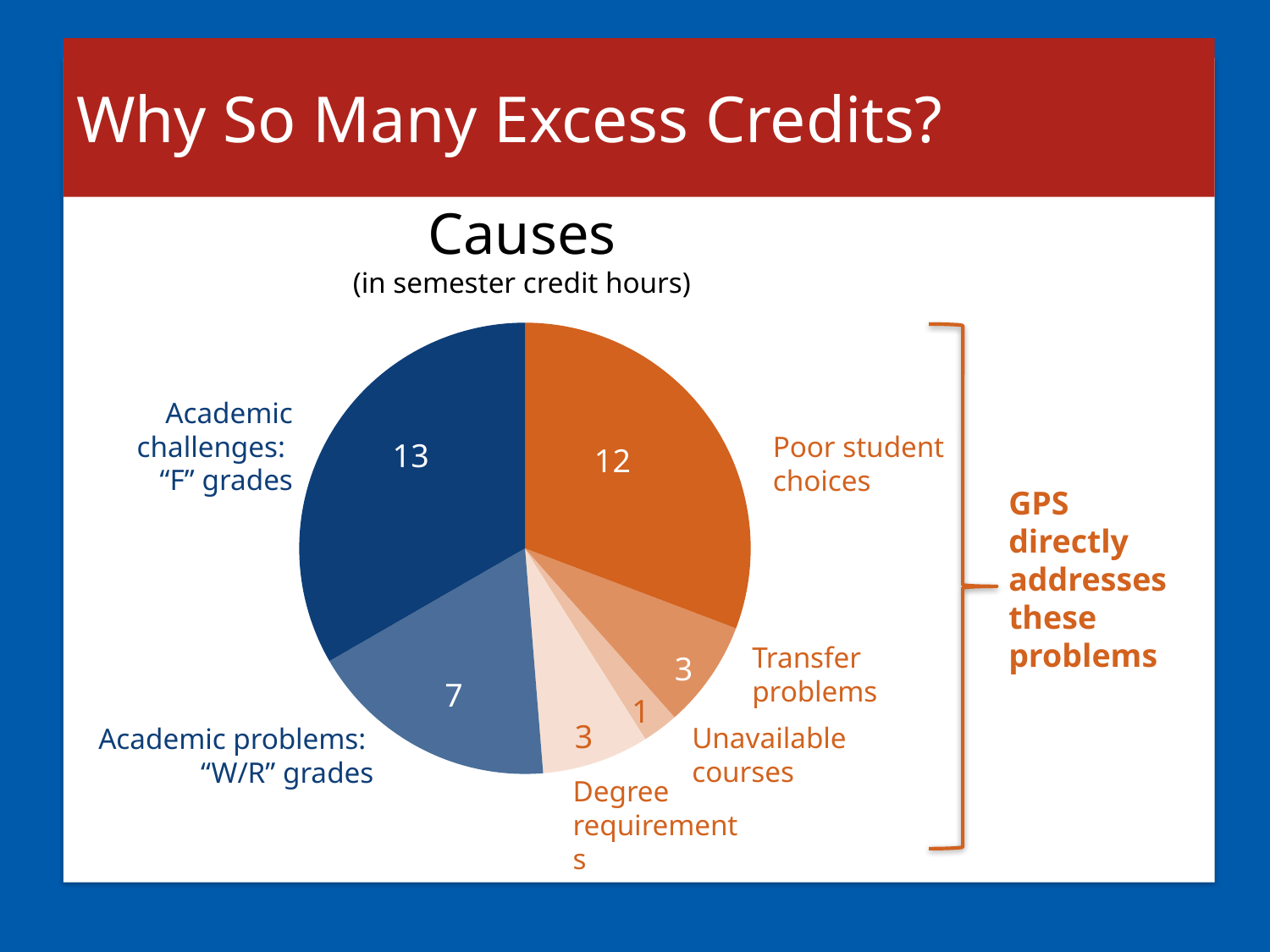
In what unit are the values in the pie chart expressed, according to the chart subtitle? semester credit hours Which is larger, the value for Poor student choices or the value for Academic problems: "W/R" grades? Poor student choices What is the value for Academic problems: "W/R" grades? 7 Which cause accounts for the smallest slice of the pie? Unavailable courses What is the difference between the values for Academic challenges: "F" grades and Poor student choices? 1 What kind of chart is shown on the slide? pie chart What is the value for Transfer problems? 3 How many semester credit hours are attributed to Academic challenges: "F" grades? 13 What is the value for Poor student choices? 12 What is the value for Unavailable courses? 1 Which cause accounts for the largest slice of the pie? Academic challenges: "F" grades How many slices does the pie chart have? 6